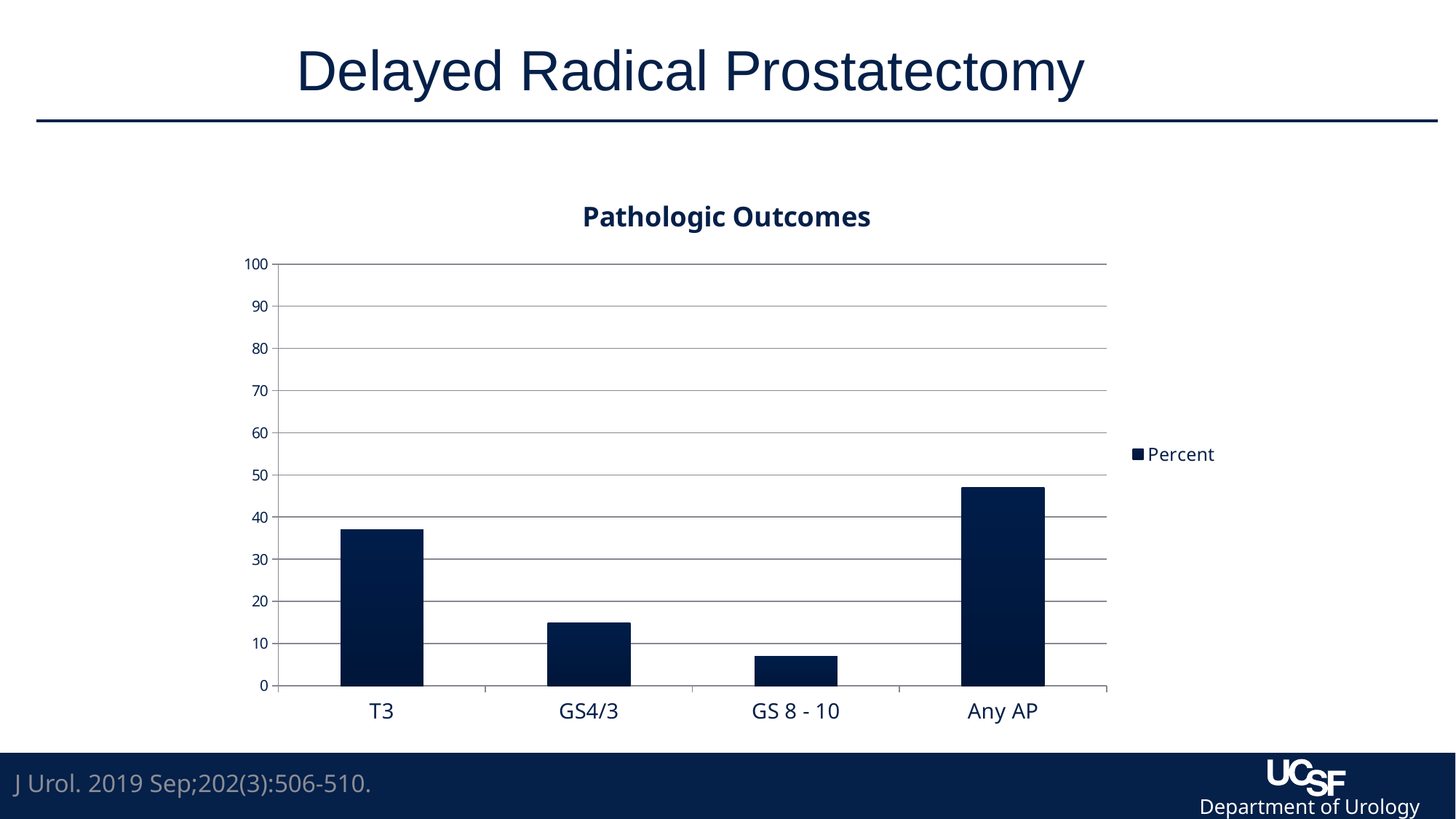
Which category has the highest value? Any AP How many series does the legend list? 1 Which category has the lowest value? GS 8 - 10 What is the title of the chart? Pathologic Outcomes What is the name of the series shown in the legend? Percent Is the value for Any AP greater or less than 50? less Is the value for T3 greater or less than 30? greater How many categories are shown on the x axis of the chart? 4 Is the value for GS4/3 greater or less than 20? less What kind of chart is shown on the slide? bar chart Which is larger, the value for T3 or the value for GS4/3? T3